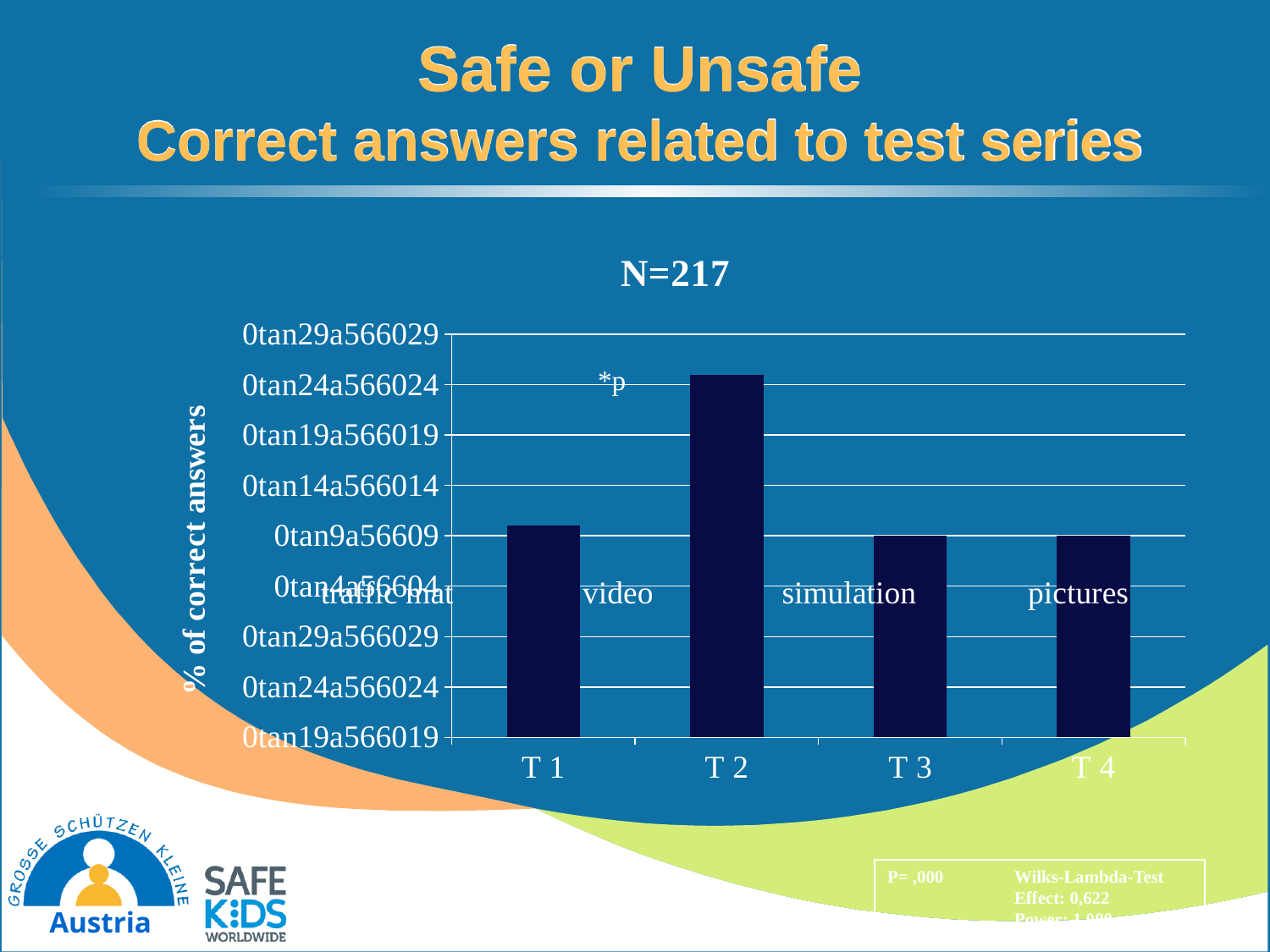
What is the label of the chart's vertical axis? % of correct answers Which has the larger value, T 2 or T 3? T 2 Does the value rise or fall from T 2 to T 3? fall How many test series (categories) are plotted on the x axis of the chart? 4 Which test series has the highest percentage of correct answers? T 2 Does the value rise or fall from T 1 to T 2? rise Which has the larger value, T 1 or T 2? T 2 Which has the larger value, T 2 or T 4? T 2 What kind of chart is shown on the slide? bar chart What is the title shown above the chart? N=217